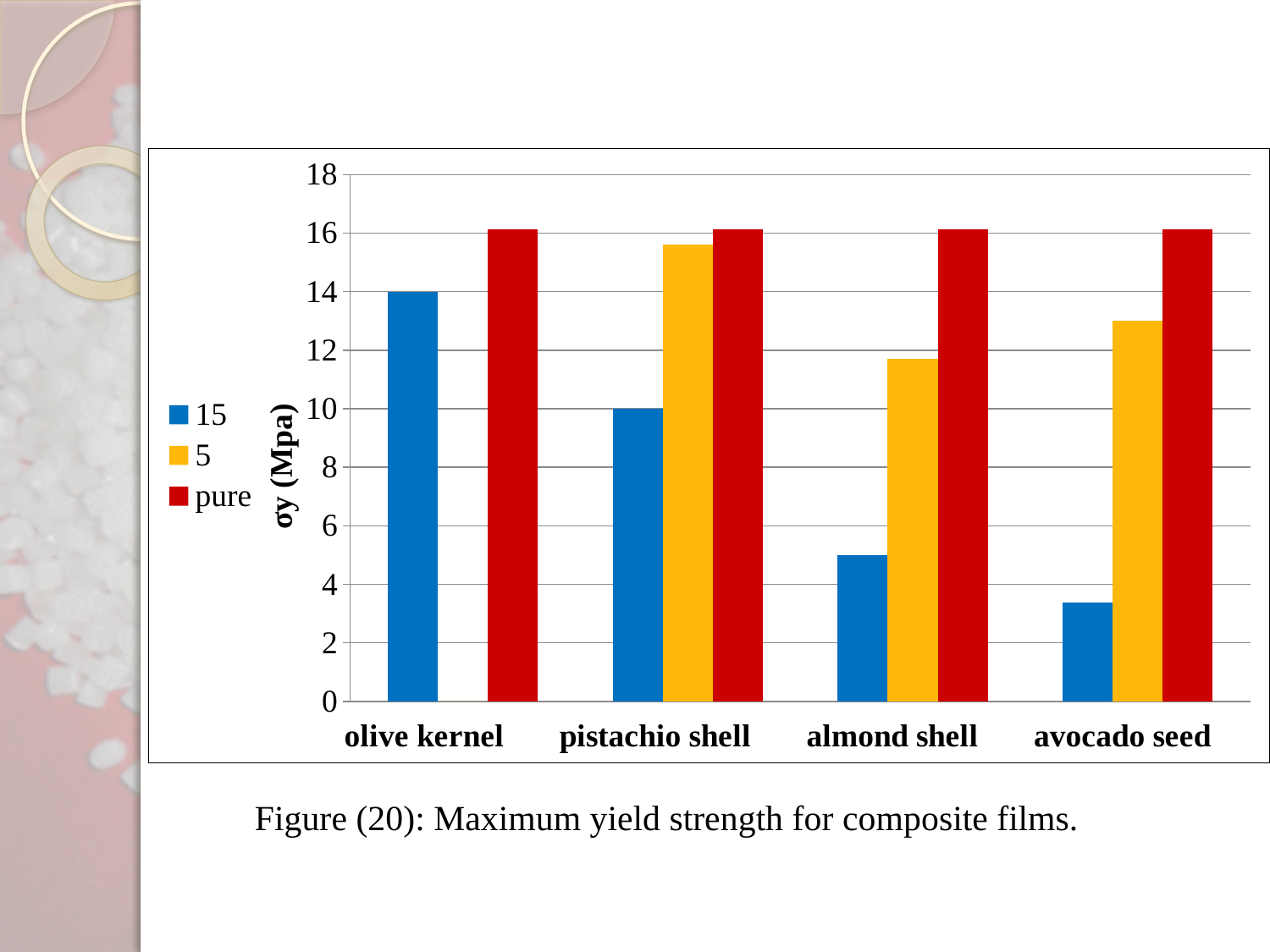
Which category has the highest value in the 5 series? pistachio shell What is the value of the 15 series for pistachio shell? 10 Is the value of the 15 series for almond shell greater or less than 6? less What is the value of the 15 series for olive kernel? 14 How many categories are shown on the x axis of the chart? 4 Do the values of the 15 series rise or fall from olive kernel to avocado seed along the x axis? fall Which is larger in the 15 series: almond shell or avocado seed? almond shell Is the value of the 5 series for avocado seed greater or less than 12? greater Which category has the highest value in the 15 series? olive kernel How many series does the chart's legend list? 3 What kind of chart is shown on the slide? bar chart Which category has the lowest value in the 15 series? avocado seed